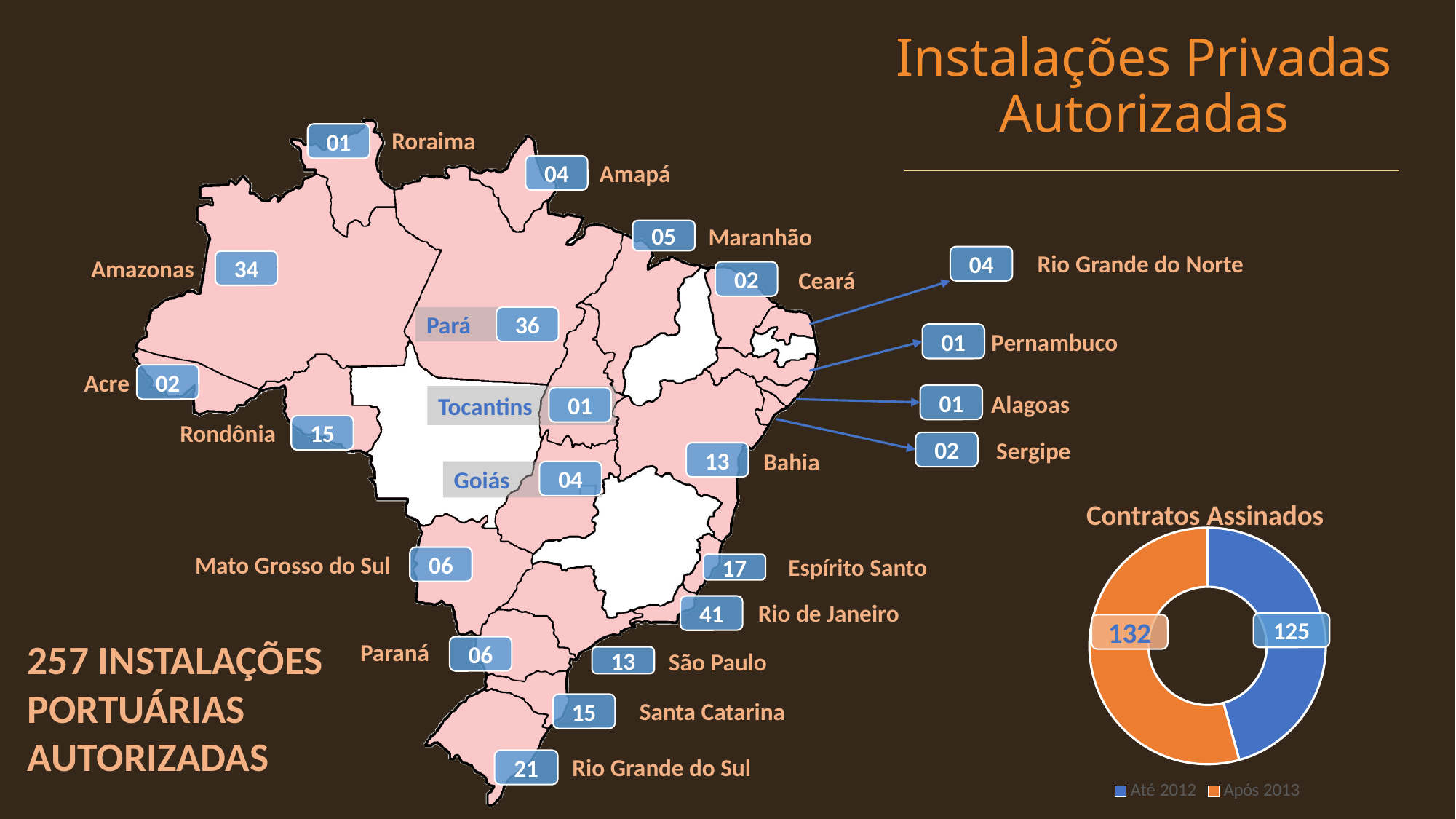
In the 'Contratos Assinados' chart, which colour represents 'Até 2012'? blue In the 'Contratos Assinados' chart, which category has the smaller value? Até 2012 How many categories does the legend of the 'Contratos Assinados' chart list? 2 What kind of chart is the 'Contratos Assinados' chart? doughnut chart In the 'Contratos Assinados' chart, is the value for 'Até 2012' larger or smaller than the value for 'Após 2013'? smaller In the 'Contratos Assinados' chart, what is the total of the two slices? 257 In the 'Contratos Assinados' chart, which category has the larger value? Após 2013 On the map, what value is shown for Rio de Janeiro? 41 In the 'Contratos Assinados' chart, what is the value for 'Após 2013'? 132 In the 'Contratos Assinados' chart, what is the difference between the values for 'Após 2013' and 'Até 2012'? 7 In the 'Contratos Assinados' chart, what is the value for 'Até 2012'? 125 On the map, what value is shown for Pará? 36